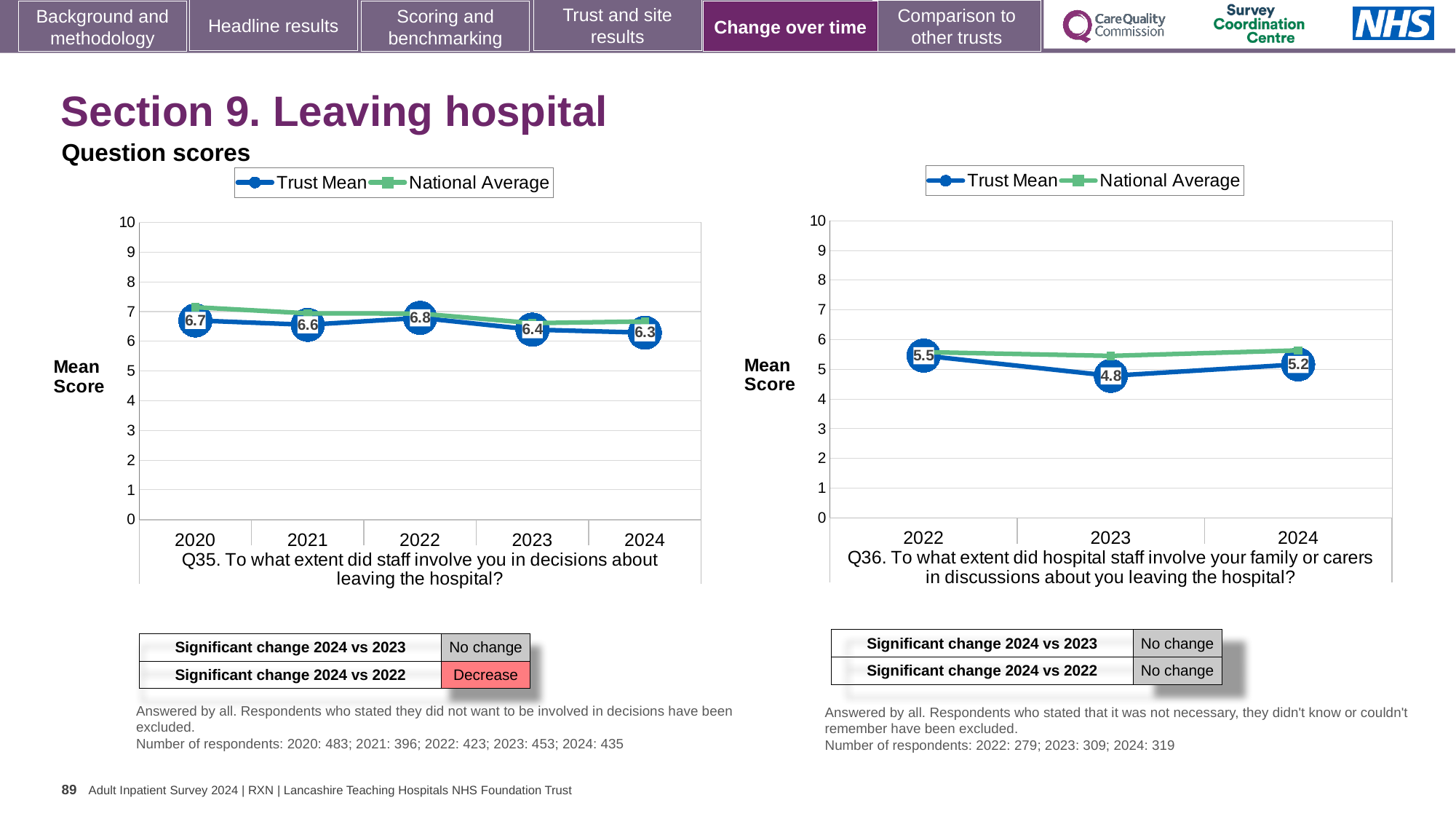
In the Q35 chart (left), what is the Trust Mean for 2024? 6.3 In the Q36 chart (right), what is the Trust Mean for 2023? 4.8 In the Q35 chart (left), what is the Trust Mean for 2020? 6.7 In the Q35 chart (left), which year has the lowest Trust Mean? 2024 How many series does the legend of the Q36 chart (right) list? 2 What type of chart is the Q35 chart (left)? Line chart In the Q35 chart (left), what is the difference between the Trust Mean in 2022 and in 2024? 0.5 In the Q36 chart (right), which year has the highest Trust Mean? 2022 In the Q35 chart (left), which year has the highest Trust Mean? 2022 In the Q35 chart (left), how many years are plotted on the x axis? 5 In the Q36 chart (right), is the Trust Mean for 2022 larger or smaller than the Trust Mean for 2024? larger In the Q36 chart (right), is the National Average for 2023 greater or less than 5? greater